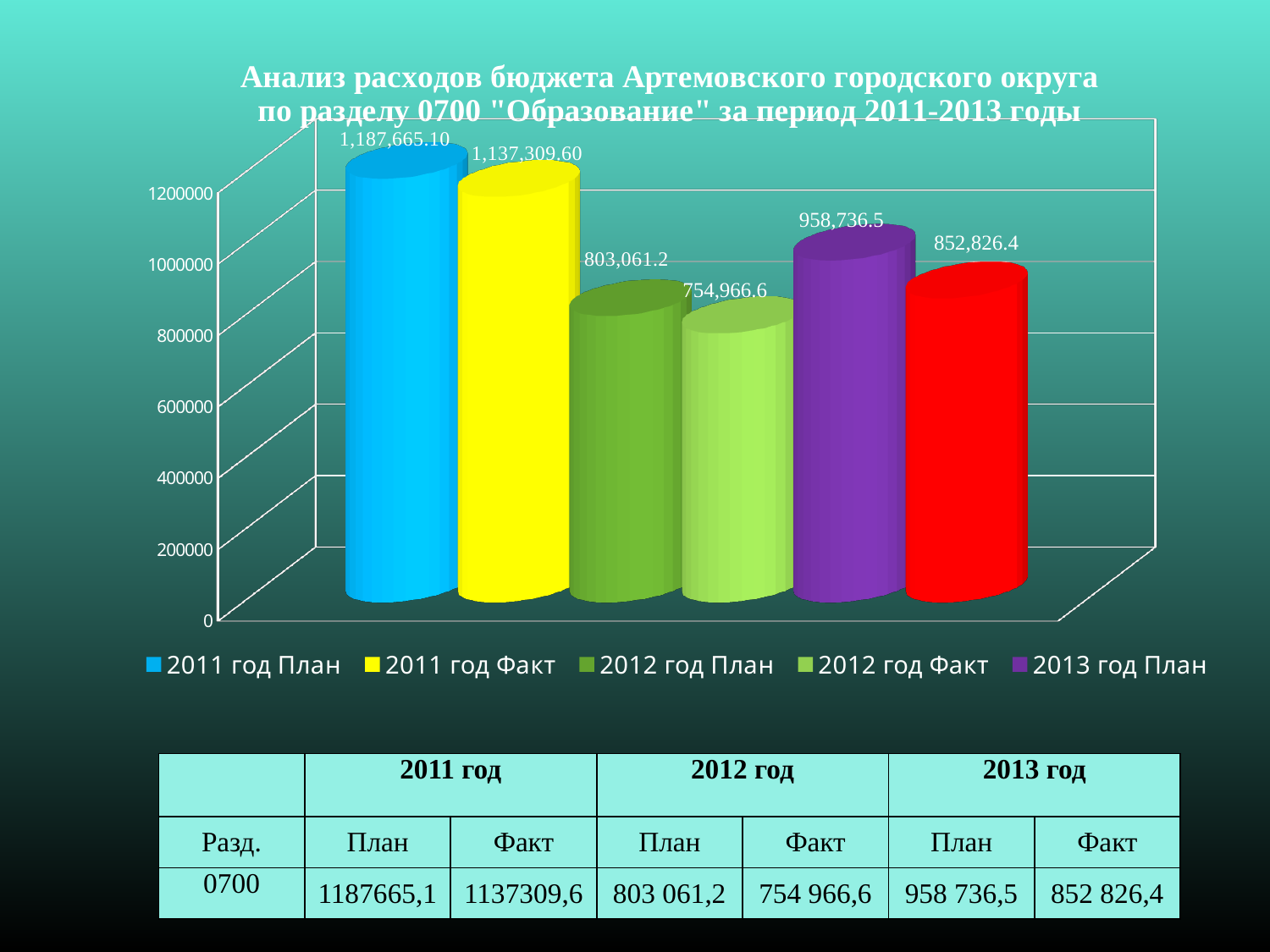
How many bars are plotted in the chart? 6 What value is labelled on the red bar at the far right of the chart? 852,826.4 Which is larger, the 2013 год План value or the 2012 год План value? 2013 год План What is the value of the 2011 год План bar? 1,187,665.10 Which series has the highest value in the chart? 2011 год План What is the difference between the 2011 год План and 2011 год Факт values? 50,355.50 What kind of chart is shown on the slide? bar chart What is the value of the 2013 год План bar? 958,736.5 What is the value of the 2012 год План bar? 803,061.2 Is the value for 2012 год Факт greater or less than 800000? less Which series has the lowest value in the chart? 2012 год Факт What is the value of the 2011 год Факт bar? 1,137,309.60